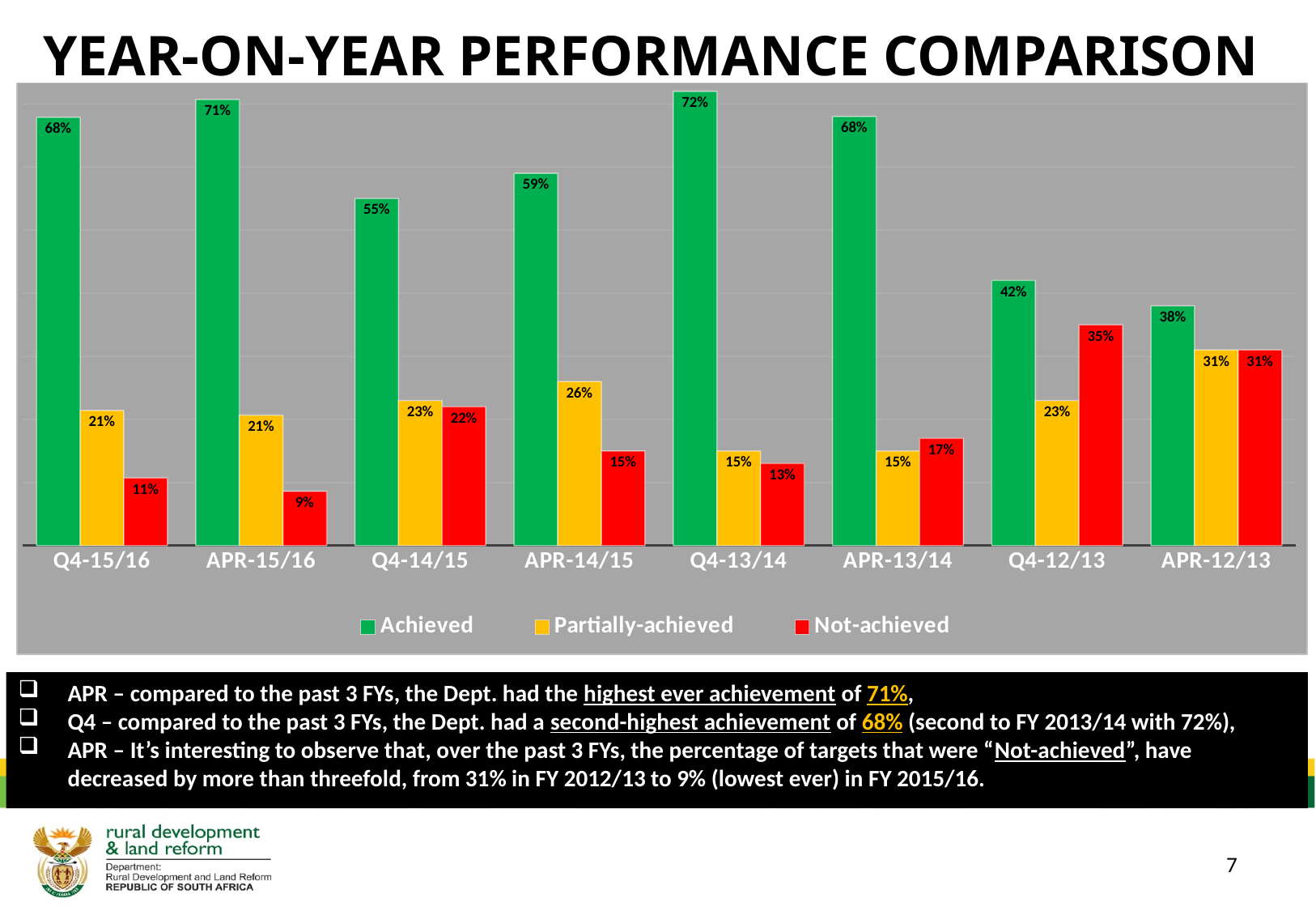
Which category has the highest Not-achieved value? Q4-12/13 Which colour represents the Not-achieved series? red What is the Achieved value for Q4-13/14? 72% What is the difference between the Achieved values for APR-15/16 and APR-12/13? 33% What is the Not-achieved value for APR-15/16? 9% What kind of chart is shown on the slide? bar chart What is the Partially-achieved value for APR-14/15? 26% Which category has the highest Achieved value? Q4-13/14 How many series does the legend list? 3 Which category has the lowest Achieved value? APR-12/13 Is the Achieved value for Q4-14/15 larger or smaller than the Achieved value for APR-14/15? smaller How many categories are shown on the x axis? 8